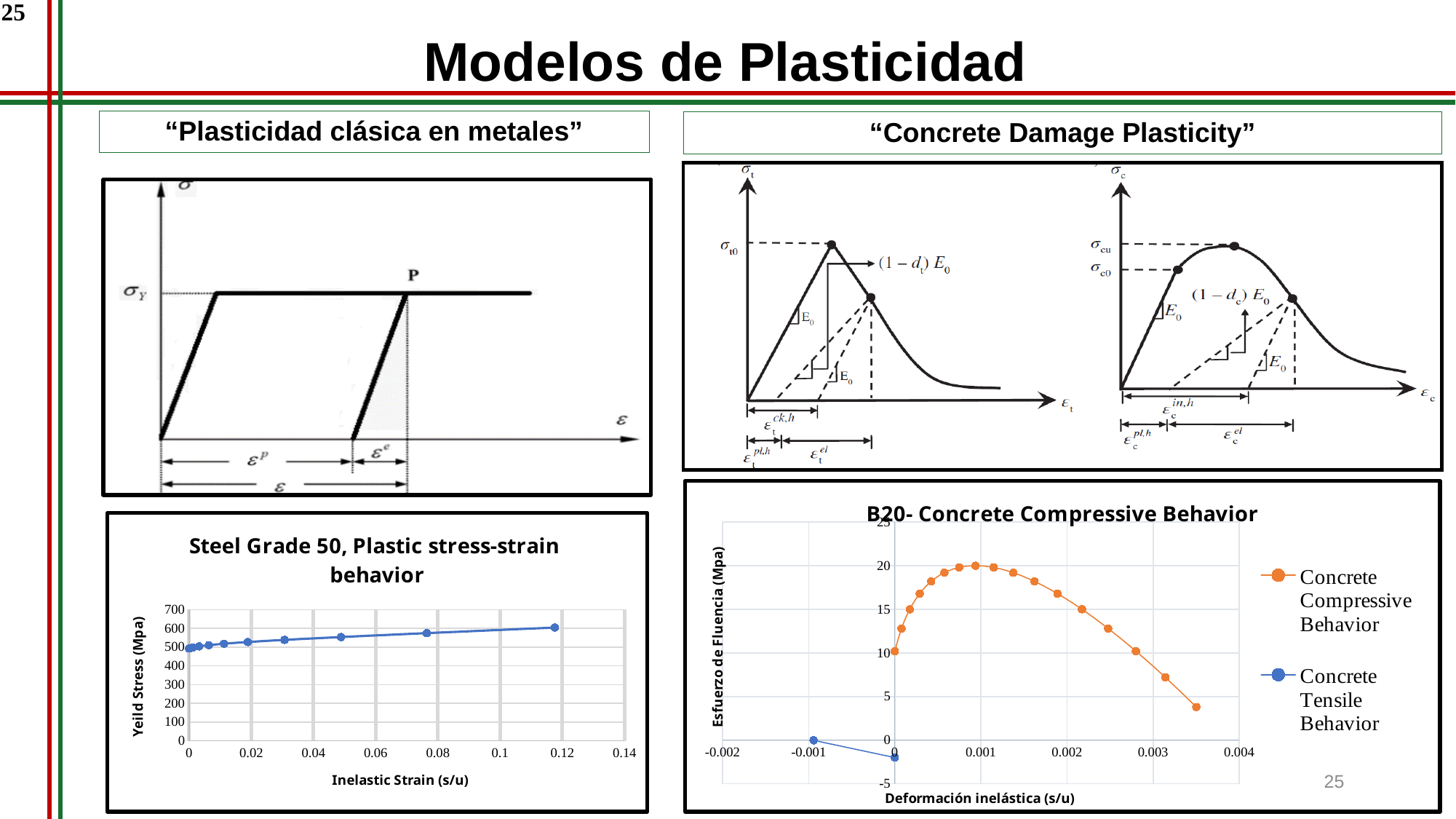
What kind of chart is the "B20- Concrete Compressive Behavior" chart? line chart In the "B20- Concrete Compressive Behavior" chart, is the peak value of the Concrete Compressive Behavior series greater or less than 15? greater In the "Steel Grade 50, Plastic stress-strain behavior" chart, does the yield stress rise or fall as inelastic strain increases? rise In the "Steel Grade 50, Plastic stress-strain behavior" chart, is the yield stress at an inelastic strain of 0 greater or less than 600? less What kind of chart is the "Steel Grade 50, Plastic stress-strain behavior" chart? line chart In the "Steel Grade 50, Plastic stress-strain behavior" chart, is the yield stress at the highest plotted strain (near 0.12) greater or less than 500? greater How many series does the legend of the "B20- Concrete Compressive Behavior" chart list? 2 In the "B20- Concrete Compressive Behavior" chart, does the Concrete Compressive Behavior series rise or fall after its peak near a strain of 0.001? fall In the "B20- Concrete Compressive Behavior" chart, which series reaches higher values, Concrete Compressive Behavior or Concrete Tensile Behavior? Concrete Compressive Behavior In the "B20- Concrete Compressive Behavior" chart, which colour represents the Concrete Tensile Behavior series? blue What is the y-axis title of the "Steel Grade 50, Plastic stress-strain behavior" chart? Yeild Stress (Mpa)